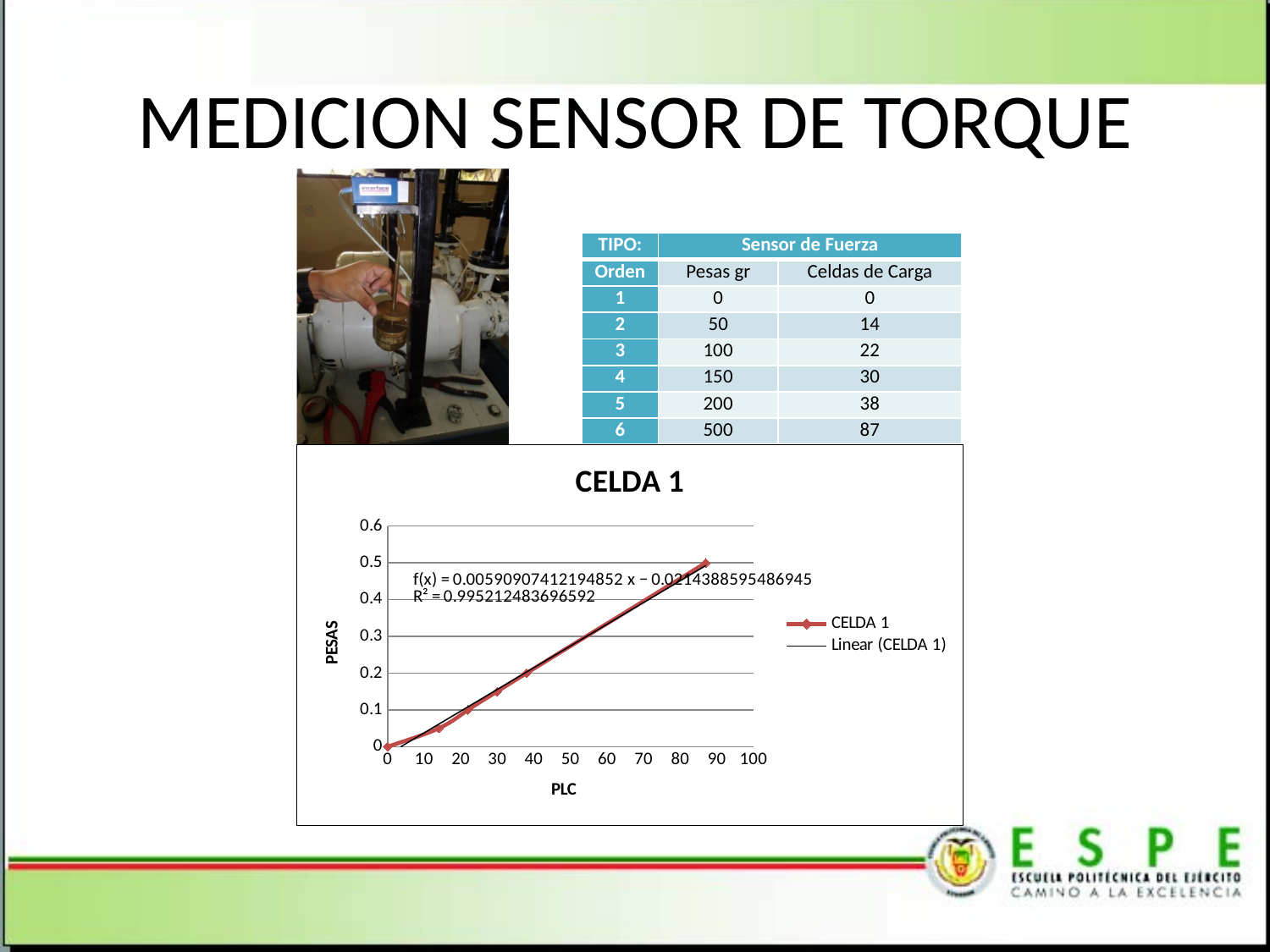
What is the title of the chart? CELDA 1 Is the PESAS value of the highest plotted point greater or less than 0.4? greater Do the PESAS values rise or fall as PLC increases along the x axis? rise What is the maximum value shown on the y axis of the chart? 0.6 Is the PESAS value of the point at about PLC 38 greater or less than 0.3? less How many series does the chart legend list? 2 Is the PLC value of the highest plotted point greater or less than 80? greater How many data points are plotted for the CELDA 1 series? 6 What kind of chart is shown on the slide? line chart What is the label of the x axis of the chart? PLC